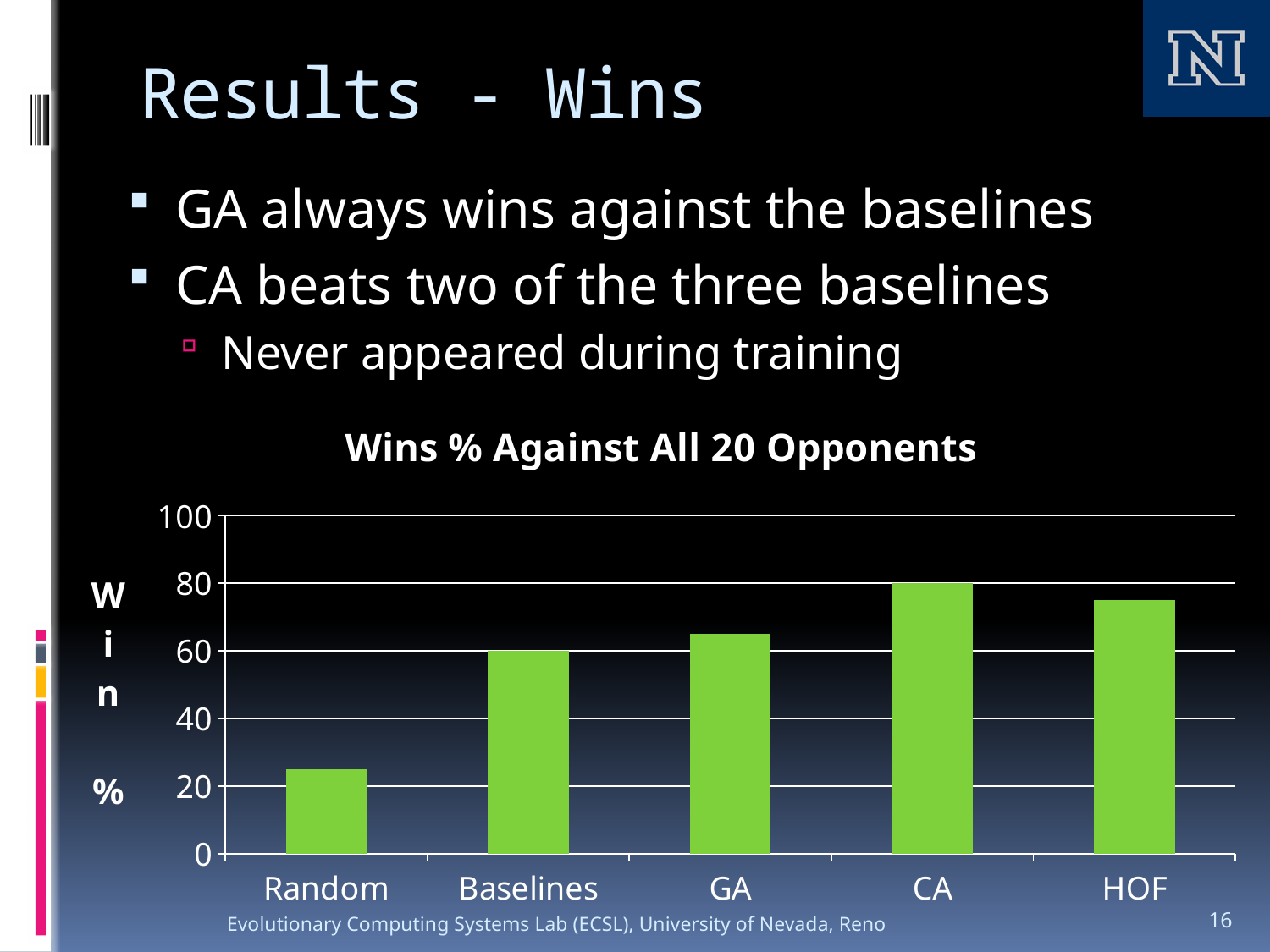
What is the title of the chart? Wins % Against All 20 Opponents What kind of chart is shown on the slide? bar chart Which has a higher win percentage, CA or HOF? CA What is the win percentage for Baselines? 60 Which category has the highest win percentage? CA Is the value for HOF greater or less than 60? greater What is the win percentage for CA? 80 What label is shown on the vertical axis of the chart? Win % What is the difference between the win percentage for CA and for Baselines? 20 Is the value for Random greater or less than 40? less How many categories are shown on the x axis of the chart? 5 Which category has the lowest win percentage? Random